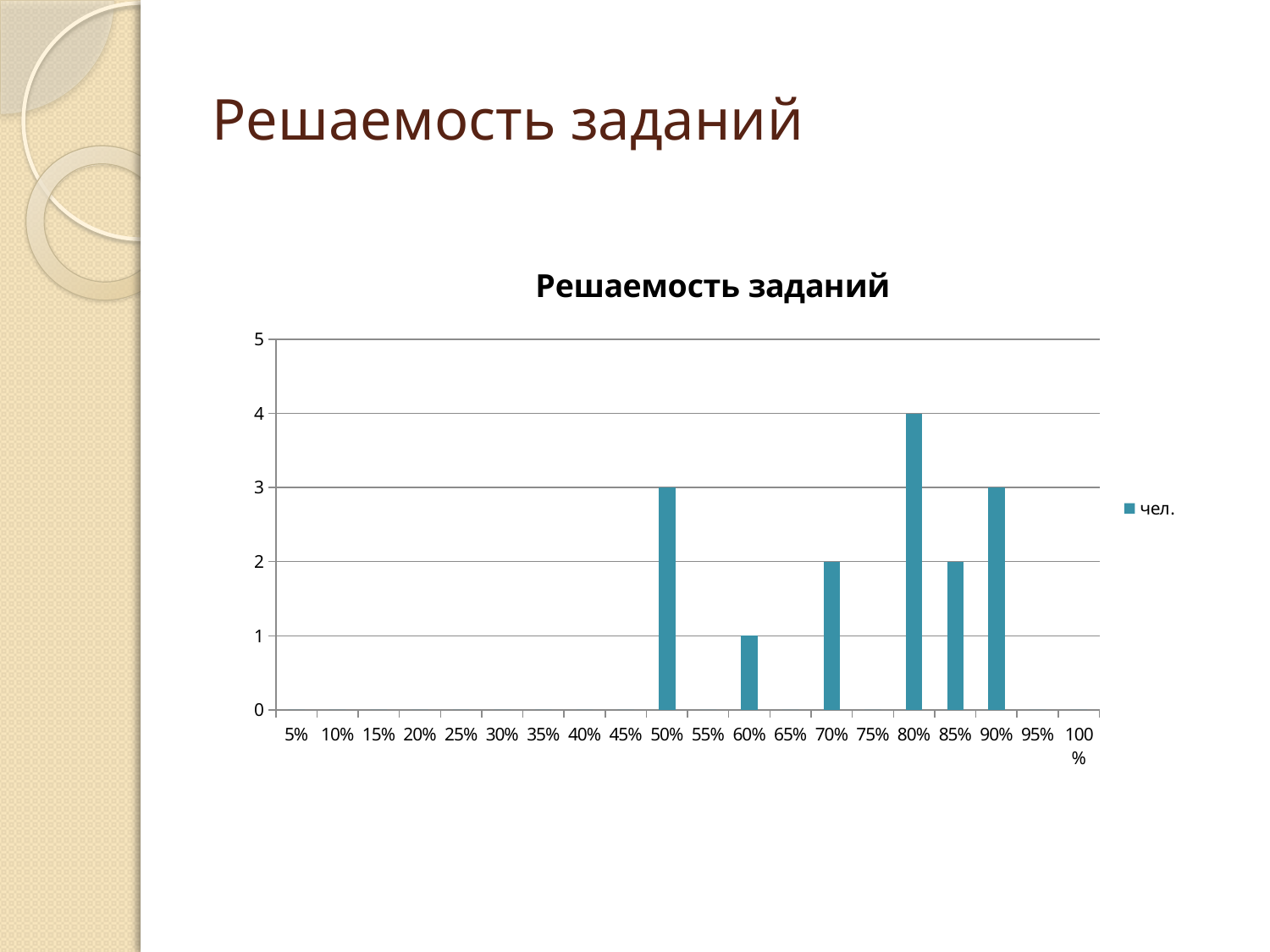
What is the value for 80%? 4 What is the value for 60%? 1 How many categories are shown on the x axis? 20 How many series does the legend list? 1 Which is larger, the value for 90% or the value for 85%? 90% Which category has the highest value? 80% What kind of chart is shown on the slide? bar chart What is the name of the series in the legend? чел. What is the difference between the values for 80% and 70%? 2 Is the value for 80% greater or less than 3? greater What is the title of the chart? Решаемость заданий What is the value for 50%? 3